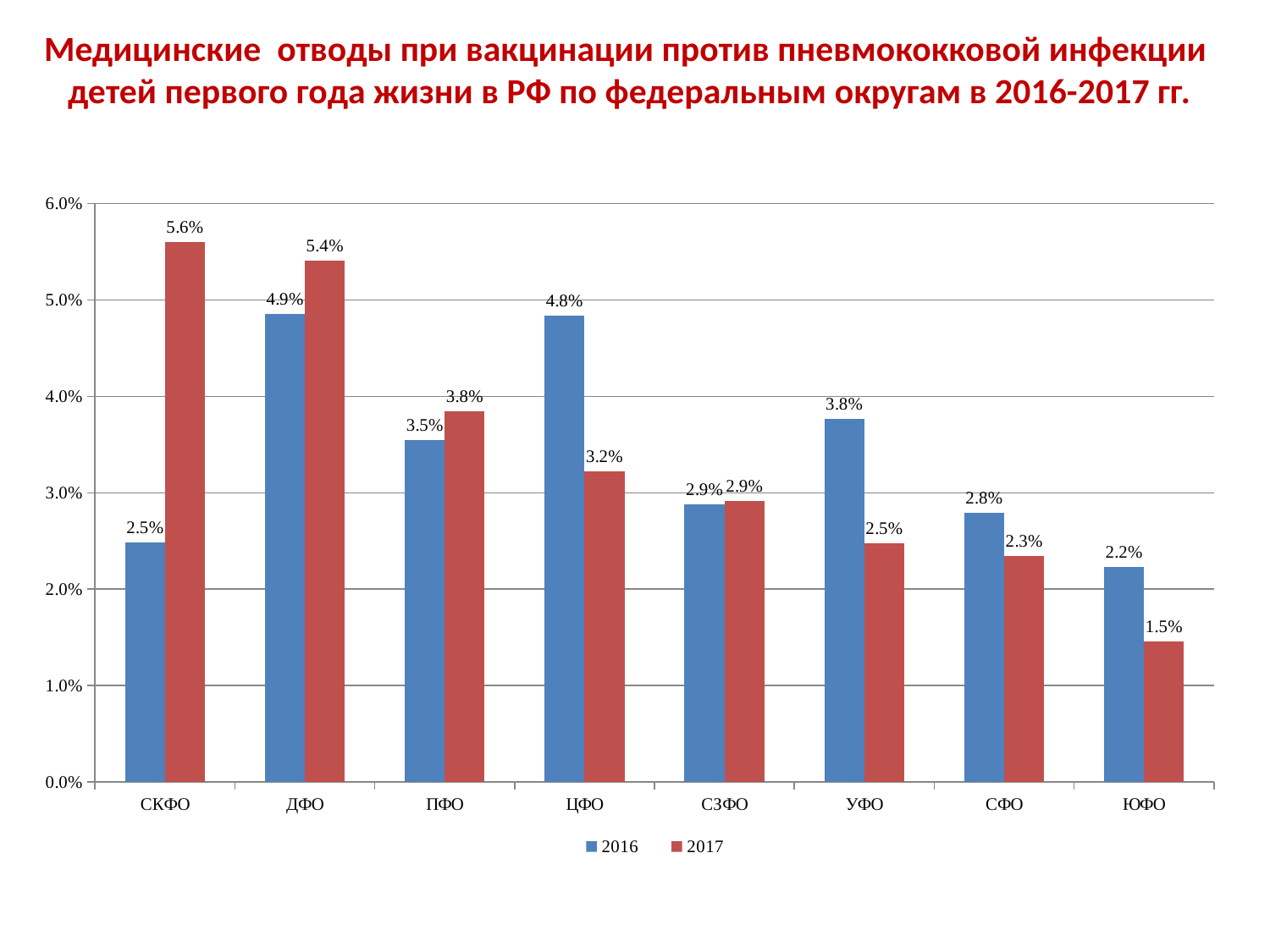
What kind of chart is shown on the slide? bar chart Which federal district has the lowest value in 2016? ЮФО Which is larger for ЦФО: the 2016 value or the 2017 value? 2016 What is the difference between the 2017 and 2016 values for СКФО? 3.1% How many series does the legend list? 2 What is the value for ЦФО in 2016? 4.8% Which federal district has the highest value in 2017? СКФО What is the value for ЮФО in 2017? 1.5% How many federal districts are shown on the x axis? 8 What is the value for СКФО in 2017? 5.6% Is the value for ДФО in 2016 greater or less than 4.0%? greater Which colour represents the 2017 series? red